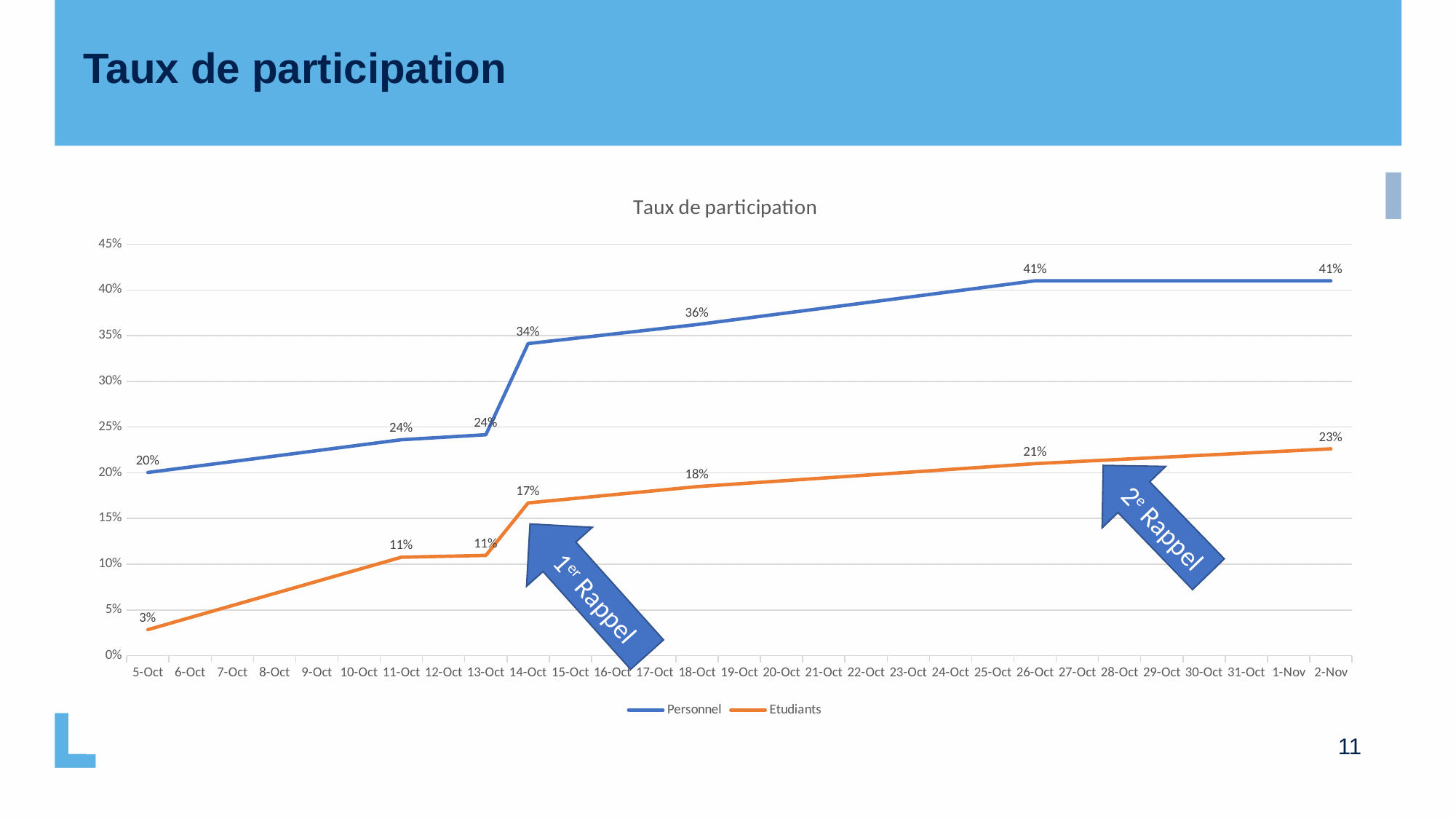
What type of chart is shown on the slide? line chart What is the difference between the Personnel value on 14-Oct and on 13-Oct? 10% What is the value for Personnel on 14-Oct? 34% Which series has the higher value on 2-Nov, Personnel or Etudiants? Personnel Does the Etudiants series rise or fall from 5-Oct to 2-Nov? rise What is the value for Etudiants on 2-Nov? 23% What is the value for Etudiants on 5-Oct? 3% What is the value for Personnel on 18-Oct? 36% Which series is drawn in orange? Etudiants What is the difference between the Personnel and Etudiants values on 26-Oct? 20% How many series does the legend list? 2